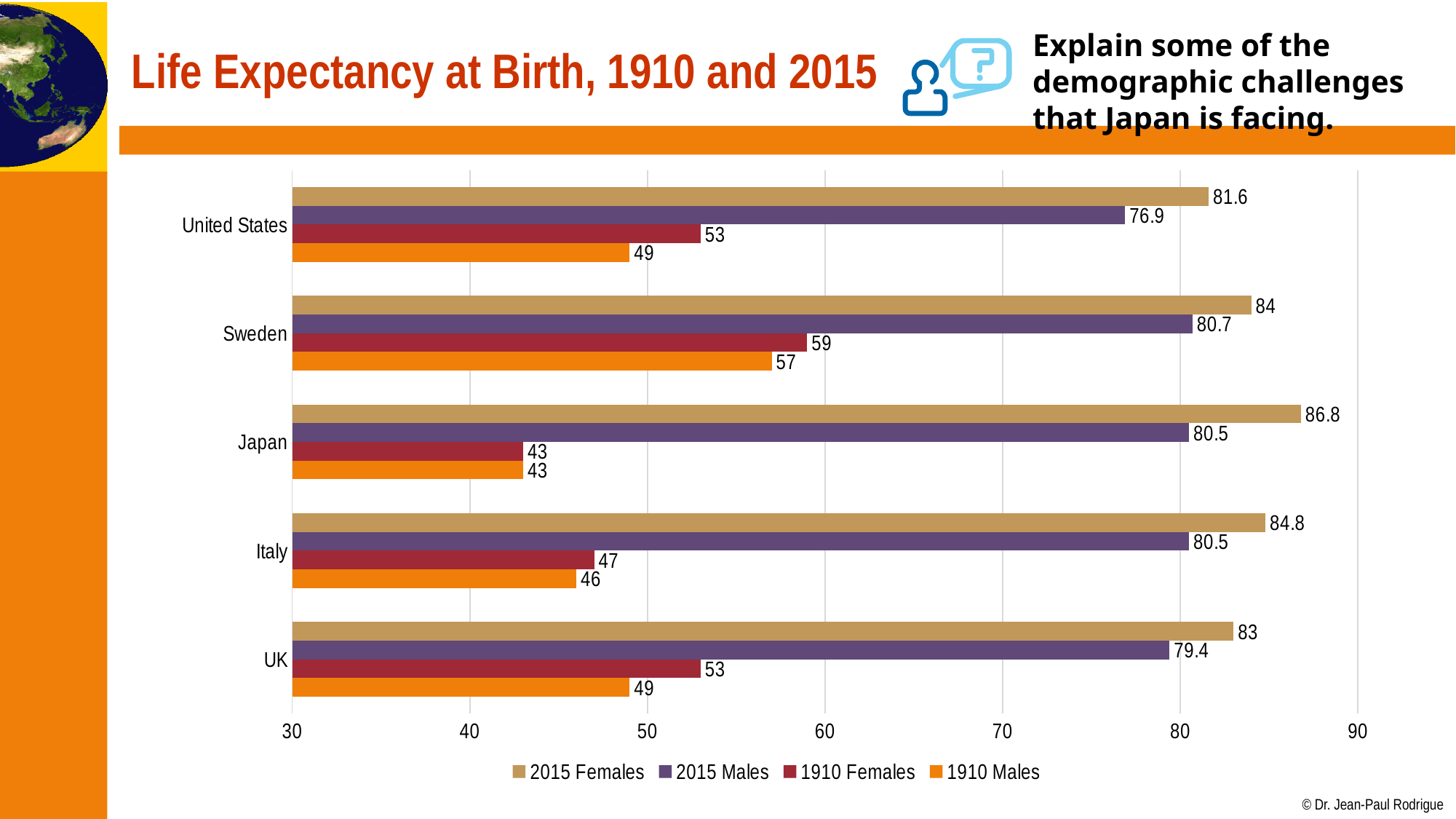
How many countries are shown on the chart? 5 How many series does the legend list? 4 What is the 2015 Females life expectancy for Japan? 86.8 What kind of chart is shown on the slide? bar chart Is the 1910 Males value for Italy greater or less than 50? less Which is larger, the 2015 Males value for Sweden or the 2015 Males value for the UK? Sweden What is the difference between the 2015 Females and 1910 Females life expectancy for Japan? 43.8 What is the title of the chart on the slide? Life Expectancy at Birth, 1910 and 2015 Which country has the lowest 1910 Females life expectancy? Japan What is the 1910 Males life expectancy for Sweden? 57 Which country has the highest 2015 Females life expectancy? Japan What is the 2015 Males life expectancy for the United States? 76.9